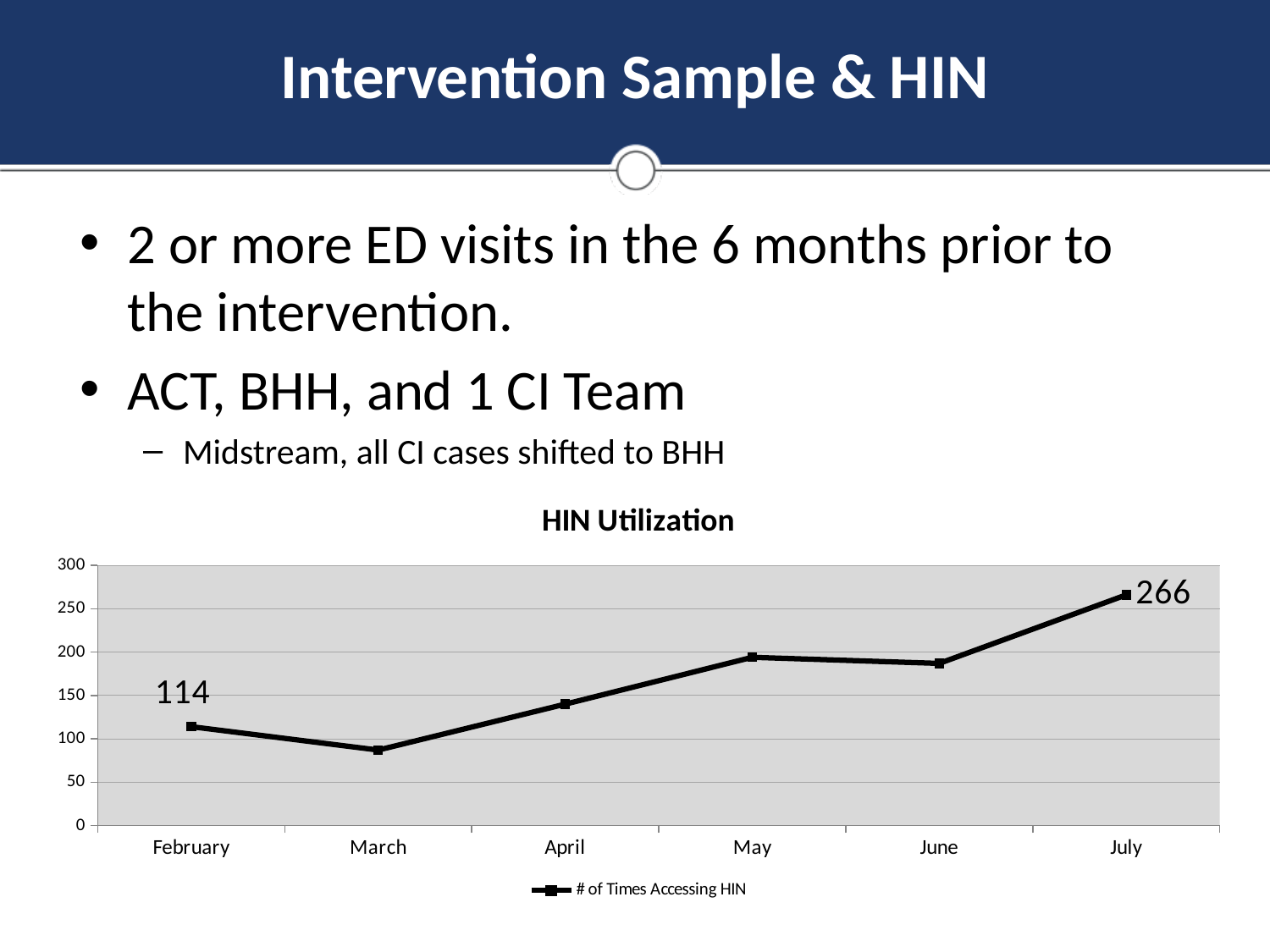
What kind of chart is the HIN Utilization chart? line chart Which month has the highest value in the HIN Utilization chart? July Is the value for May greater or less than 150? greater Which is larger, the value for May or the value for June? May How many months are plotted in the HIN Utilization chart? 6 What is the value for July in the HIN Utilization chart? 266 How many series does the legend of the HIN Utilization chart list? 1 What is the value for February in the HIN Utilization chart? 114 What is the difference between the July and February values in the HIN Utilization chart? 152 Is the value for March greater or less than 100? less What is the series name shown in the legend of the HIN Utilization chart? # of Times Accessing HIN Which month has the lowest value in the HIN Utilization chart? March